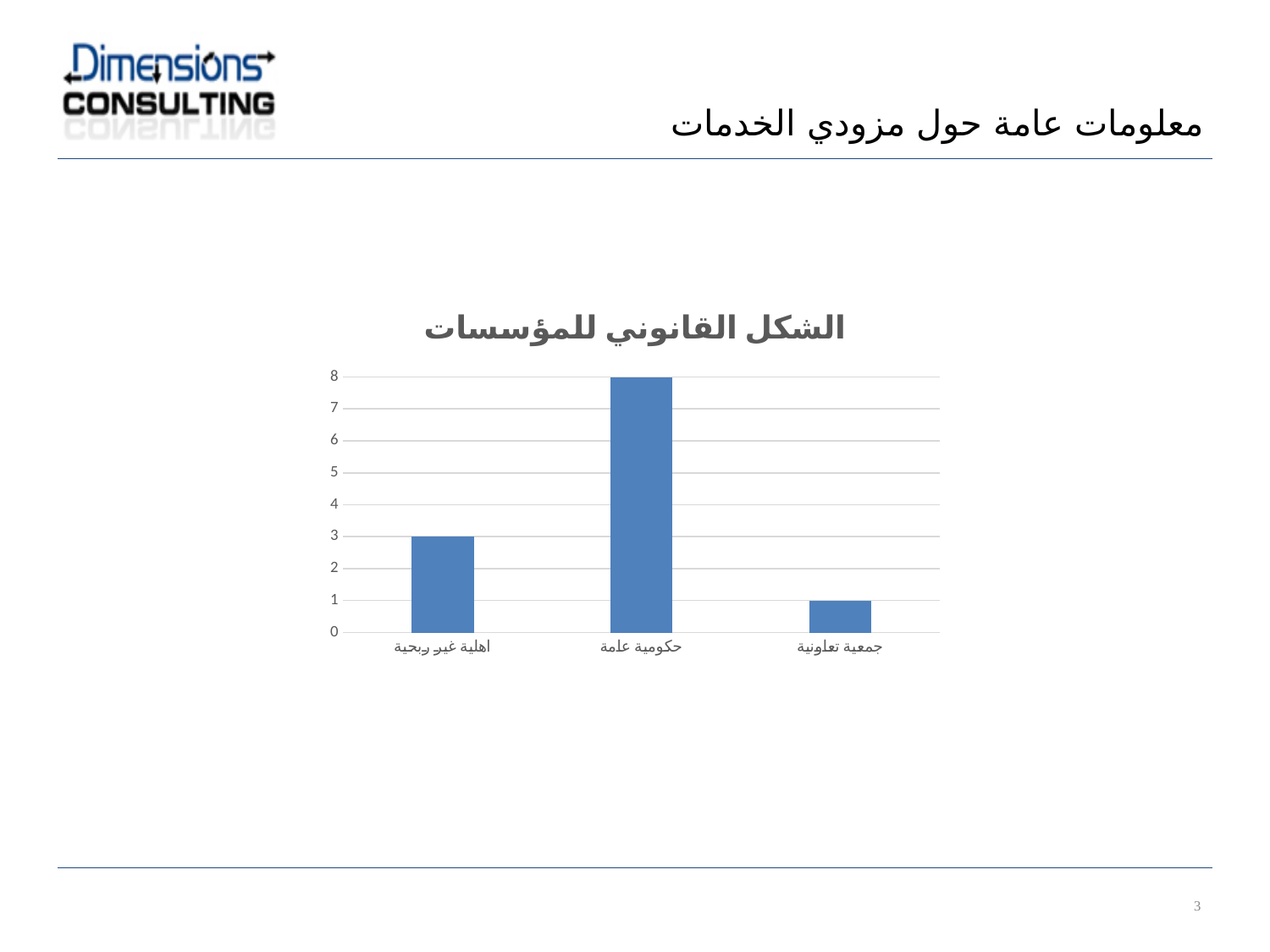
How many categories are shown in the chart? 3 What is the difference between the values for اهلية غير ربحية and جمعية تعاونية? 2 Is the value for حكومية عامة greater or less than 5? greater What kind of chart is shown on the slide? bar chart Which category has the highest value in the chart? حكومية عامة What is the title of the chart? الشكل القانوني للمؤسسات What is the value for حكومية عامة in the chart? 8 What is the value for جمعية تعاونية in the chart? 1 Which category has the lowest value in the chart? جمعية تعاونية Which is larger, the value for اهلية غير ربحية or the value for جمعية تعاونية? اهلية غير ربحية What is the value for اهلية غير ربحية in the chart? 3 What is the difference between the values for حكومية عامة and اهلية غير ربحية? 5